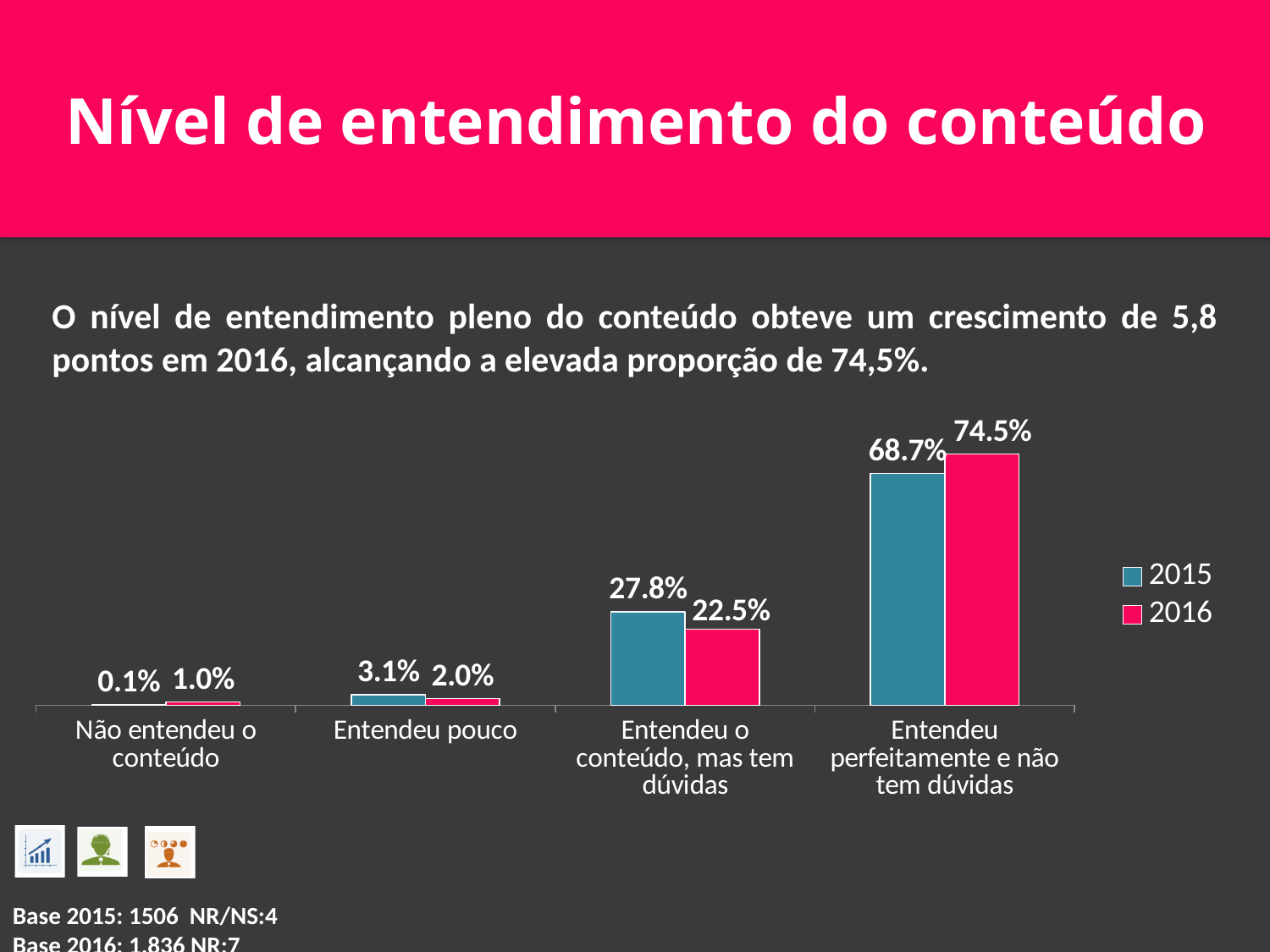
Which category has the lowest 2015 value? Não entendeu o conteúdo How many series does the legend list? 2 For "Entendeu pouco", which year has the larger value, 2015 or 2016? 2015 What is the 2015 value for "Entendeu pouco"? 3.1% Which category has the highest 2016 value? Entendeu perfeitamente e não tem dúvidas What is the 2016 value for "Não entendeu o conteúdo"? 1.0% What kind of chart is shown on the slide? Bar chart What is the 2015 value for "Entendeu o conteúdo, mas tem dúvidas"? 27.8% What is the difference between the 2016 and 2015 values for "Entendeu perfeitamente e não tem dúvidas"? 5.8 percentage points How many categories are shown on the x axis? 4 What is the 2016 value for "Entendeu perfeitamente e não tem dúvidas"? 74.5% What is the difference between the 2015 and 2016 values for "Entendeu o conteúdo, mas tem dúvidas"? 5.3 percentage points